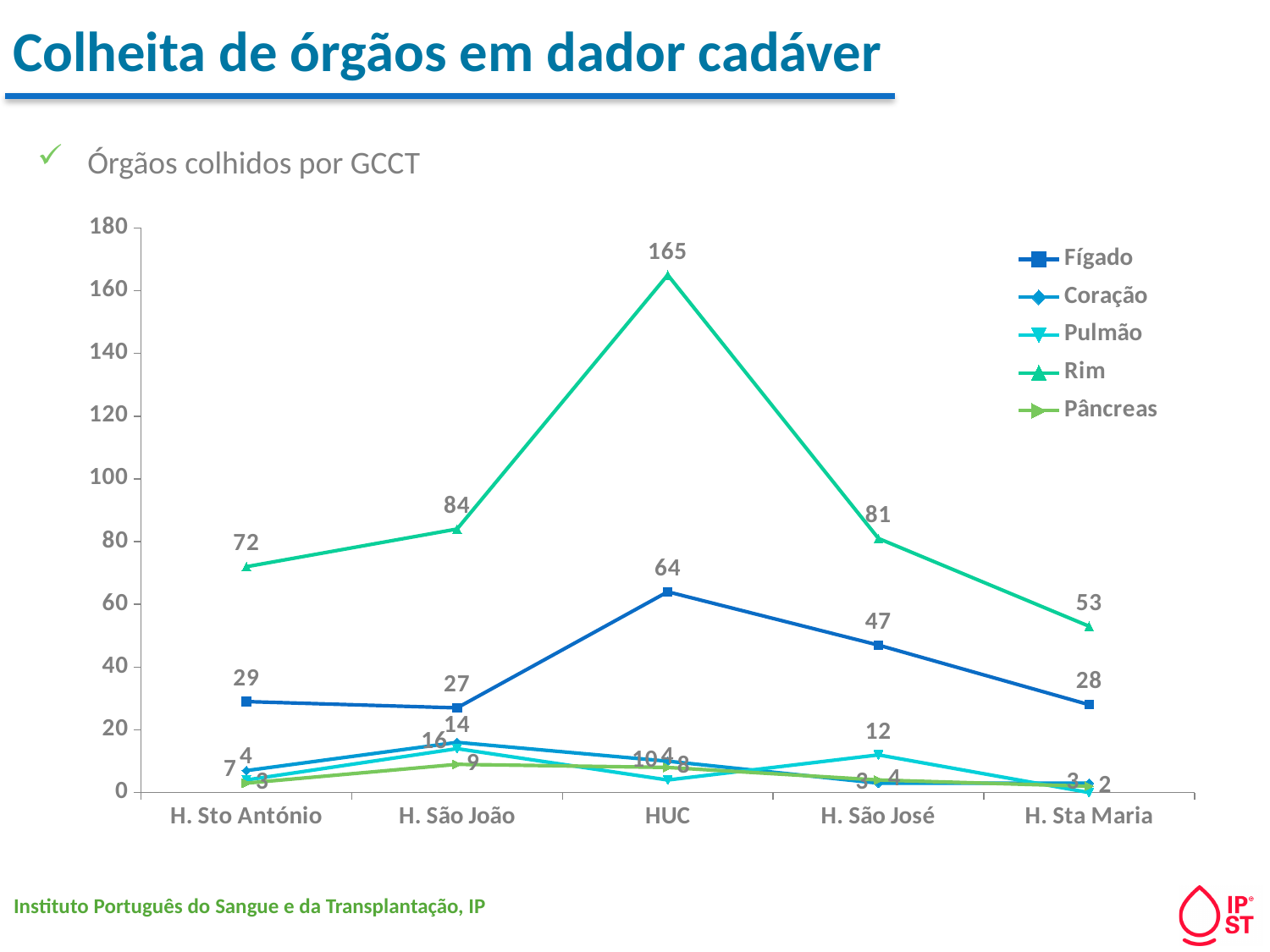
How many hospitals (categories) are shown on the x axis? 5 How many series does the legend list? 5 What is the value for Rim at HUC? 165 What is the value for Pulmão at H. São José? 12 What kind of chart is shown on the slide? line chart Which is larger: the Fígado value at HUC or the Rim value at H. Sta Maria? Fígado at HUC What is the difference between the Rim value at HUC and the Rim value at H. São José? 84 Does the Fígado series rise or fall from HUC to H. Sta Maria? fall What is the value for Fígado at H. São José? 47 For the Rim series, which hospital has the highest value? HUC Is the value for Rim at H. São João greater or less than 100? less For the Rim series, which hospital has the lowest value? H. Sta Maria